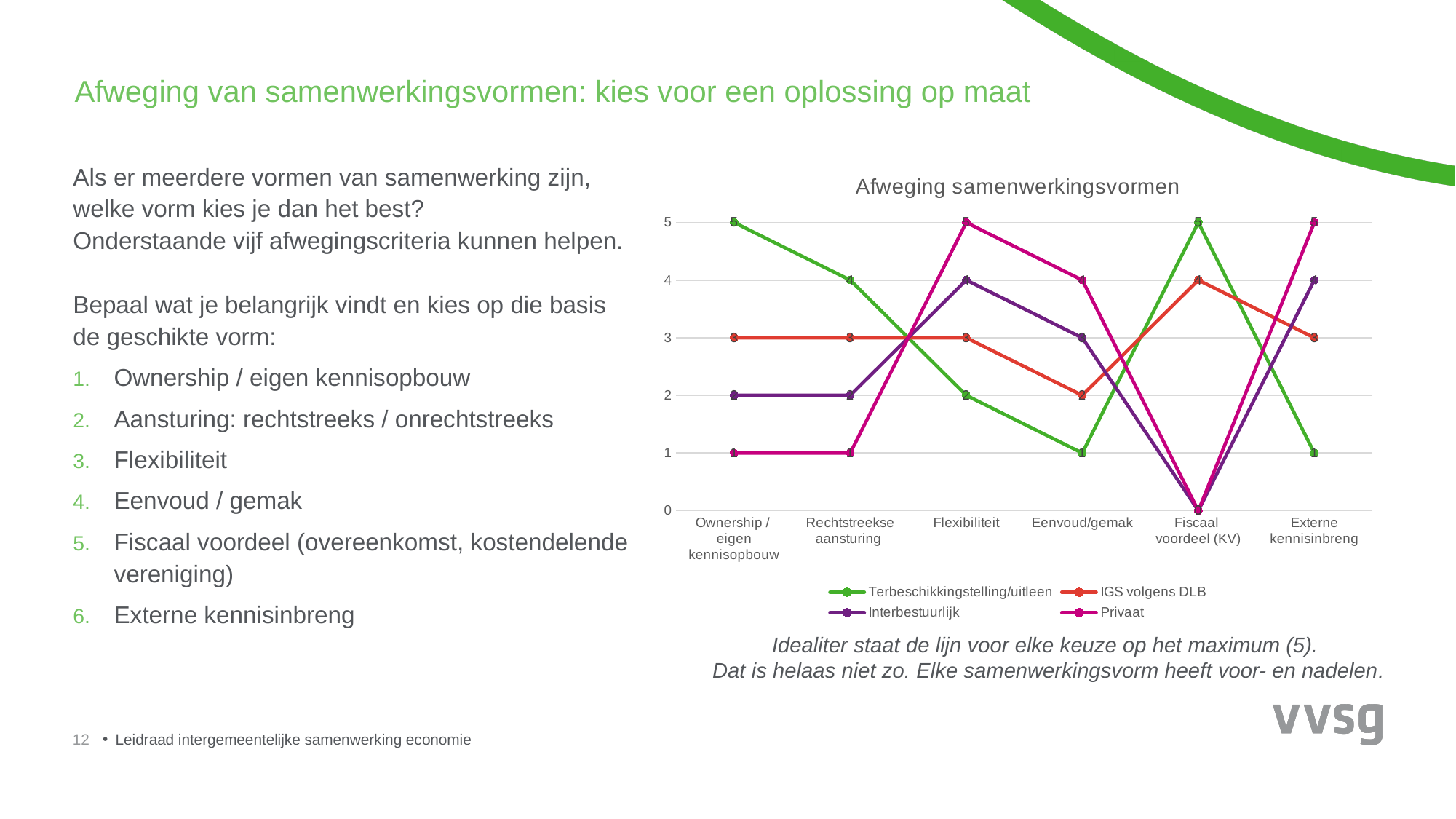
Which series has the highest value for Externe kennisinbreng? Privaat What kind of chart is shown on the slide? Line chart How many series does the legend of the chart list? 4 What is the difference between the values of Privaat and Terbeschikkingstelling/uitleen for Eenvoud/gemak? 3 For which category does Privaat have its lowest value? Fiscaal voordeel (KV) What is the value of Privaat for Flexibiliteit? 5 Which is larger for Rechtstreekse aansturing: the value of IGS volgens DLB or the value of Interbestuurlijk? IGS volgens DLB What is the title of the chart? Afweging samenwerkingsvormen What is the value of IGS volgens DLB for Eenvoud/gemak? 2 What is the value of Interbestuurlijk for Fiscaal voordeel (KV)? 0 How many categories are shown on the x axis of the chart? 6 What is the value of Terbeschikkingstelling/uitleen for Ownership / eigen kennisopbouw? 5